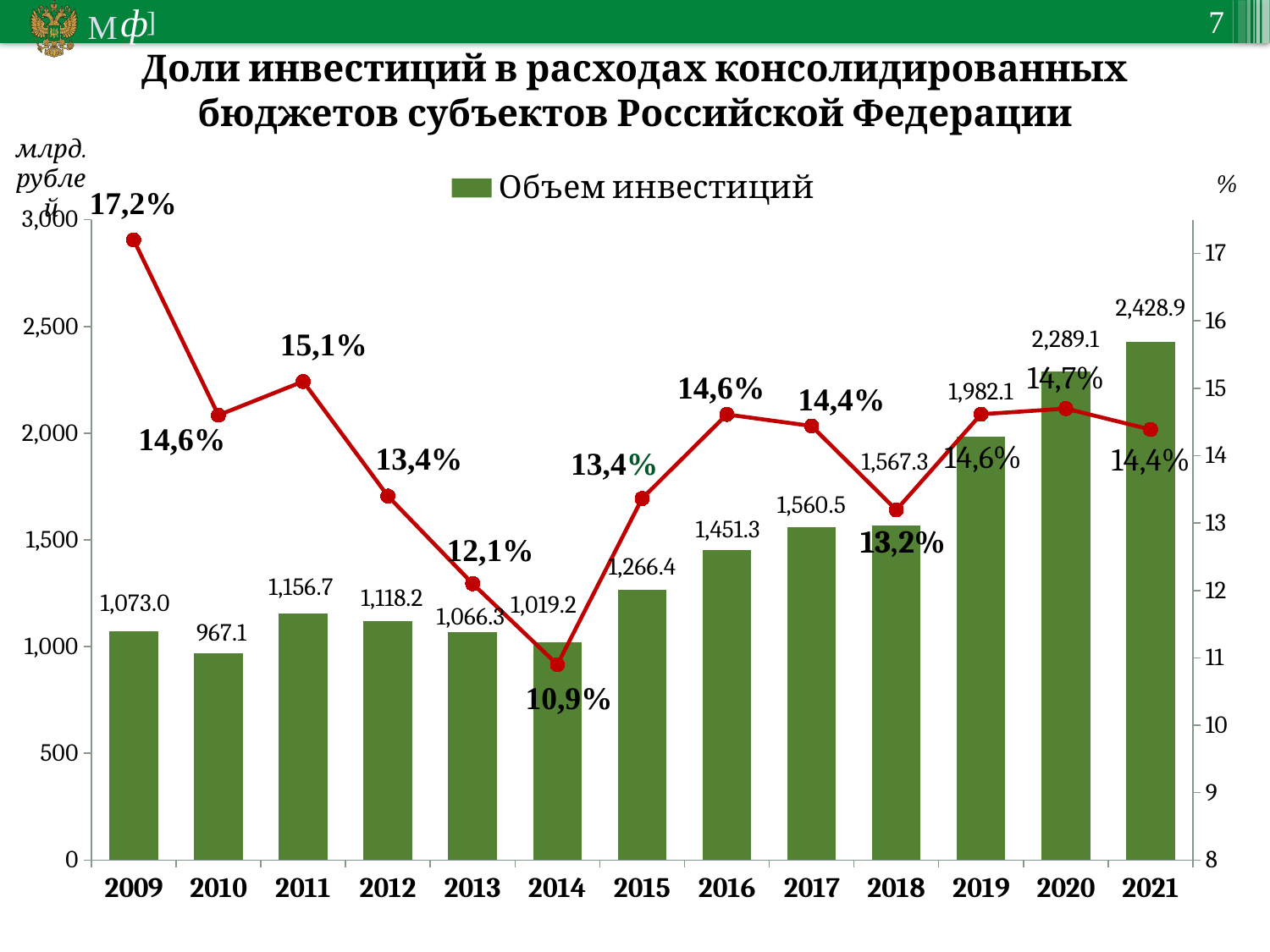
How many years are shown on the x axis? 13 Which year has the highest investment volume bar? 2021 What is the difference between the investment volume in 2021 and in 2020? 139.8 What share percentage is shown on the line for 2014? 10,9% In which year is the share percentage on the line highest? 2009 Which year has the larger investment volume, 2011 or 2012? 2011 How many series does the legend list? 1 Which year has the lowest investment volume bar? 2010 In which year is the share percentage on the line lowest? 2014 What is the investment volume (Объем инвестиций) shown for 2021? 2,428.9 Do the investment volume bars rise or fall from 2014 to 2021? rise What is the investment volume shown for 2010? 967.1